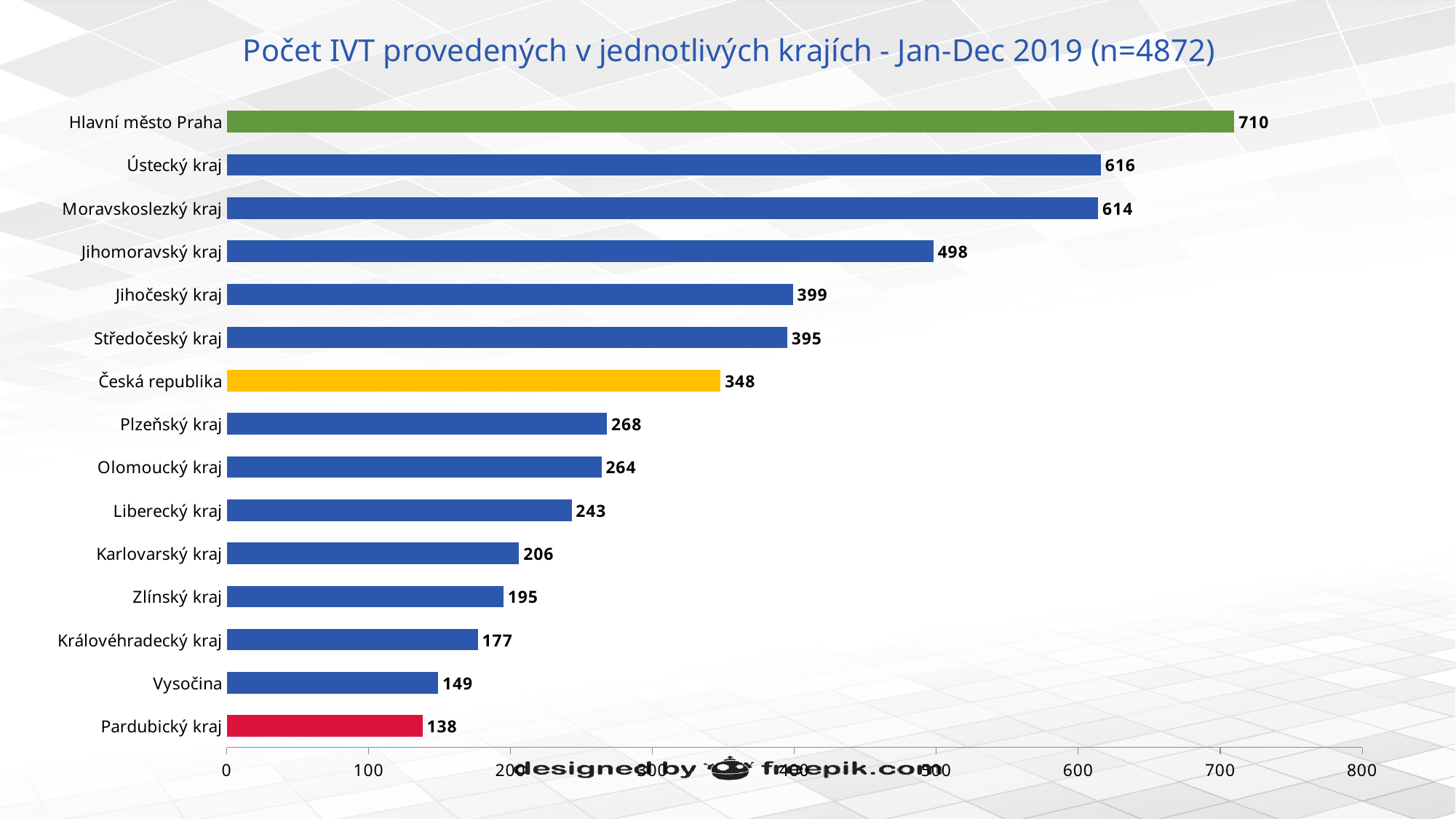
How many categories are shown on the chart? 15 Which category has the lowest value? Pardubický kraj What kind of chart is shown on the slide? bar chart Which category has the highest value? Hlavní město Praha Which is larger, the value for Jihomoravský kraj or the value for Jihočeský kraj? Jihomoravský kraj What is the difference between the values for Hlavní město Praha and Pardubický kraj? 572 What is the value for Česká republika? 348 What is the value for Hlavní město Praha? 710 What is the title of the chart? Počet IVT provedených v jednotlivých krajích - Jan-Dec 2019 (n=4872) Is the value for Liberecký kraj greater or less than 200? greater What is the difference between the values for Ústecký kraj and Moravskoslezský kraj? 2 What is the value for Karlovarský kraj? 206